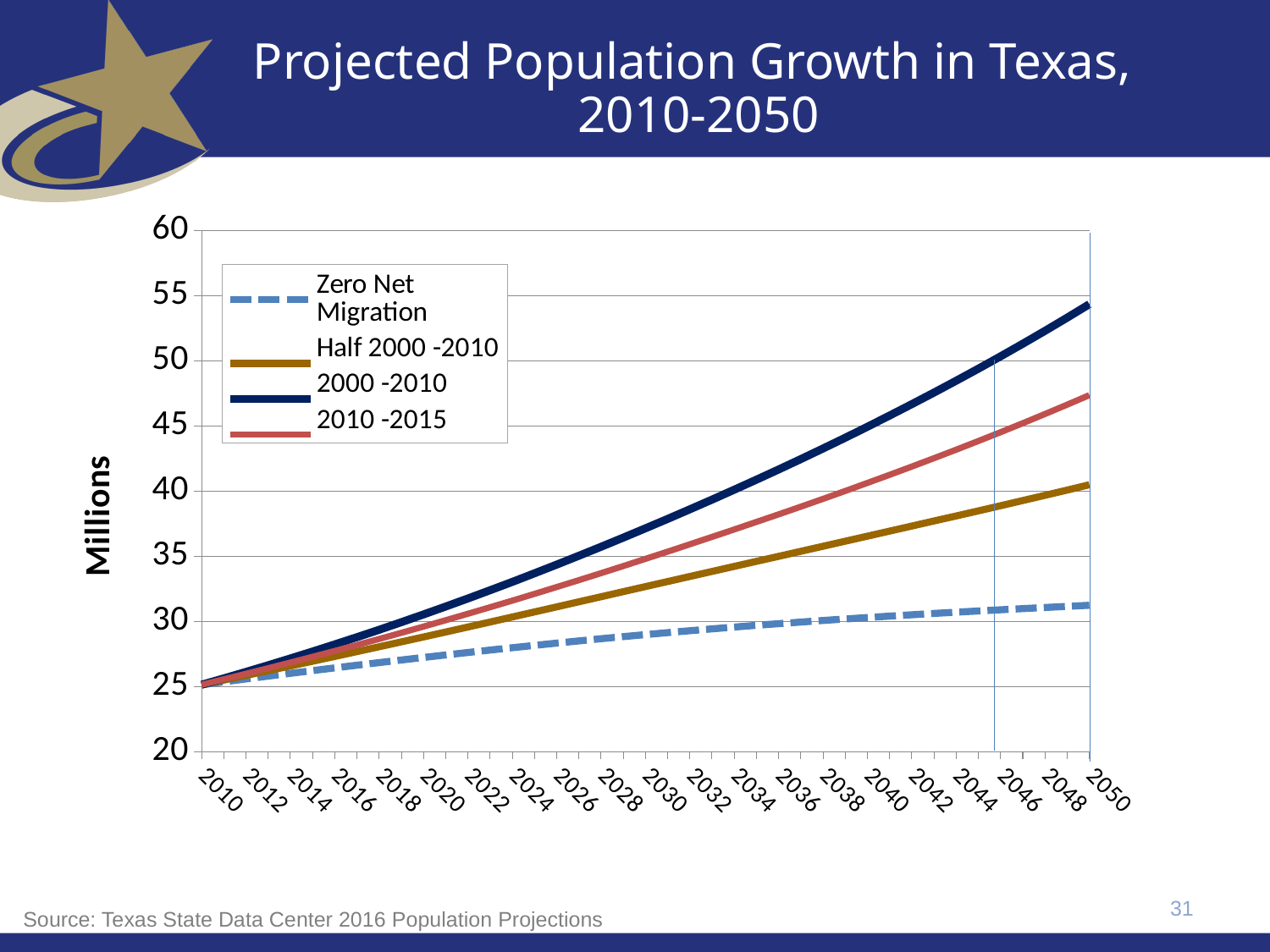
How many series does the legend list? 4 What is the title of the chart? Projected Population Growth in Texas, 2010-2050 In 2050, which is larger: the value for the 2010 -2015 series or the Half 2000 -2010 series? 2010 -2015 Is the value for the 2010 -2015 series in 2050 greater or less than 45? greater What is the label on the vertical axis? Millions Do the values for the 2000 -2010 series rise or fall from 2010 to 2050? Rise What kind of chart is shown on the slide? Line chart Is the value for the 2000 -2010 series in 2050 greater or less than 50? greater Is the value for the Zero Net Migration series in 2050 greater or less than 35? less Which series has the highest projected population in 2050? 2000 -2010 Which series has the lowest projected population in 2050? Zero Net Migration